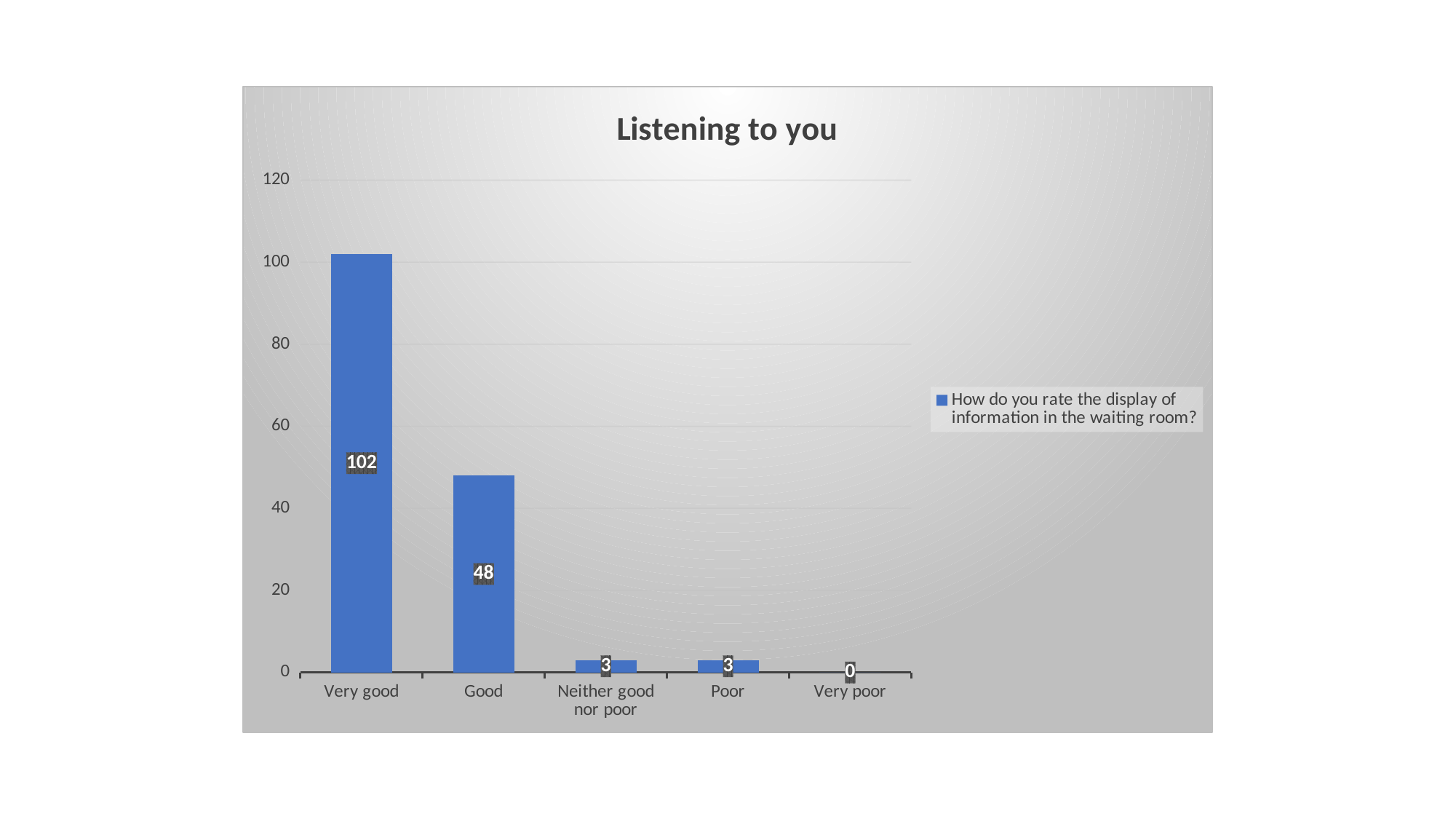
What is the title of the chart? Listening to you Which is larger, the value for Good or the value for Poor? Good Is the value for Very good greater or less than 100? greater How many categories are shown on the x axis? 5 Which category has the highest value? Very good What is the value for Very good? 102 What is the value for Very poor? 0 What kind of chart is shown? Bar chart What is the difference between the values for Very good and Good? 54 What is the value for Good? 48 Which category has the lowest value? Very poor What is the value for Neither good nor poor? 3